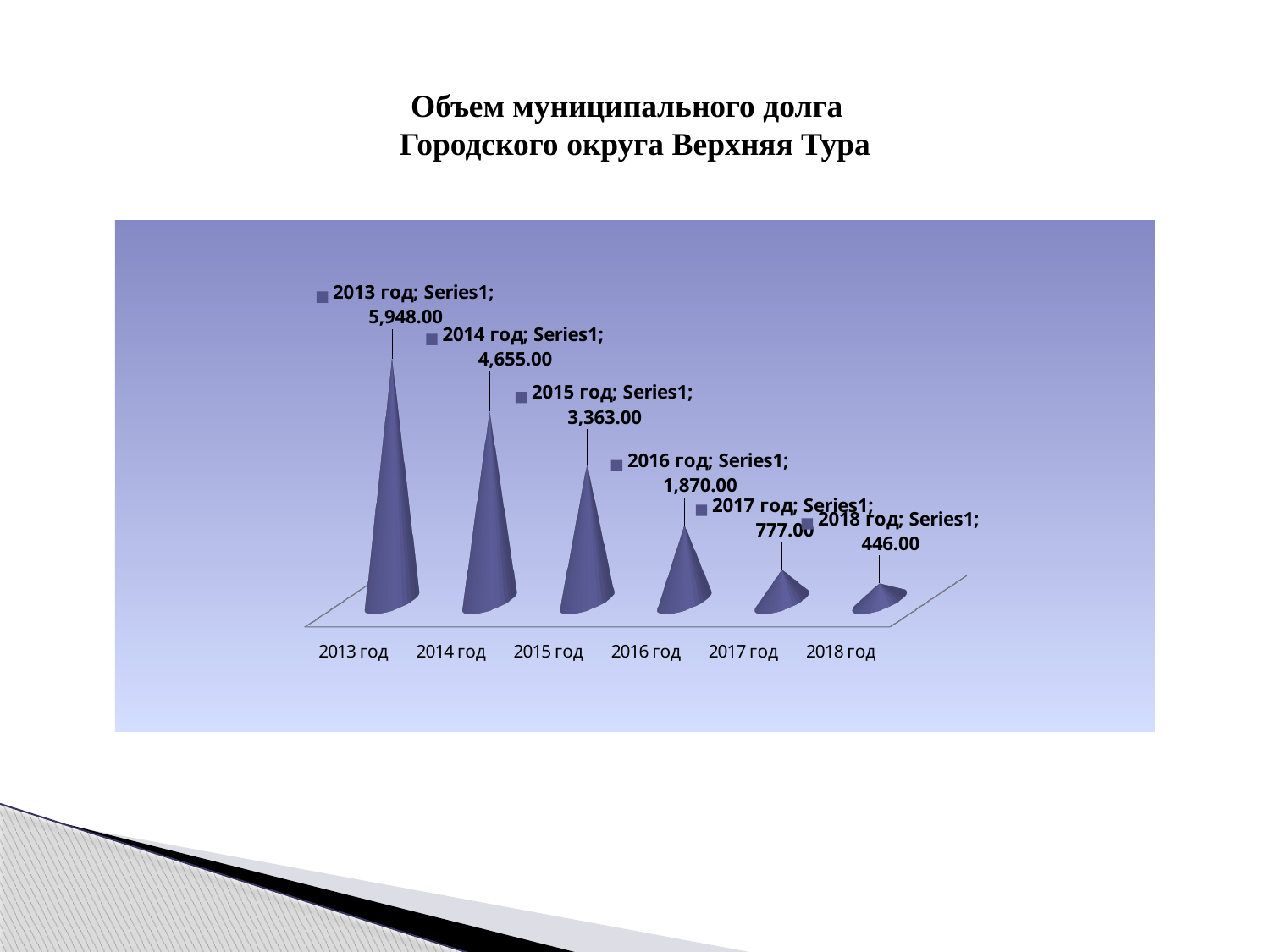
What is the value for 2013 год? 5,948.00 Which is larger, the value for 2016 год or the value for 2017 год? 2016 год What is the value for 2015 год? 3,363.00 What is the value for 2018 год? 446.00 How many years are shown on the x axis? 6 Which year has the lowest value? 2018 год What is the value for 2016 год? 1,870.00 What is the difference between the values for 2017 год and 2018 год? 331.00 Do the values rise or fall from 2013 год to 2018 год? Fall What kind of chart is shown on the slide? Bar chart What is the difference between the values for 2013 год and 2014 год? 1,293.00 Which year has the highest value? 2013 год